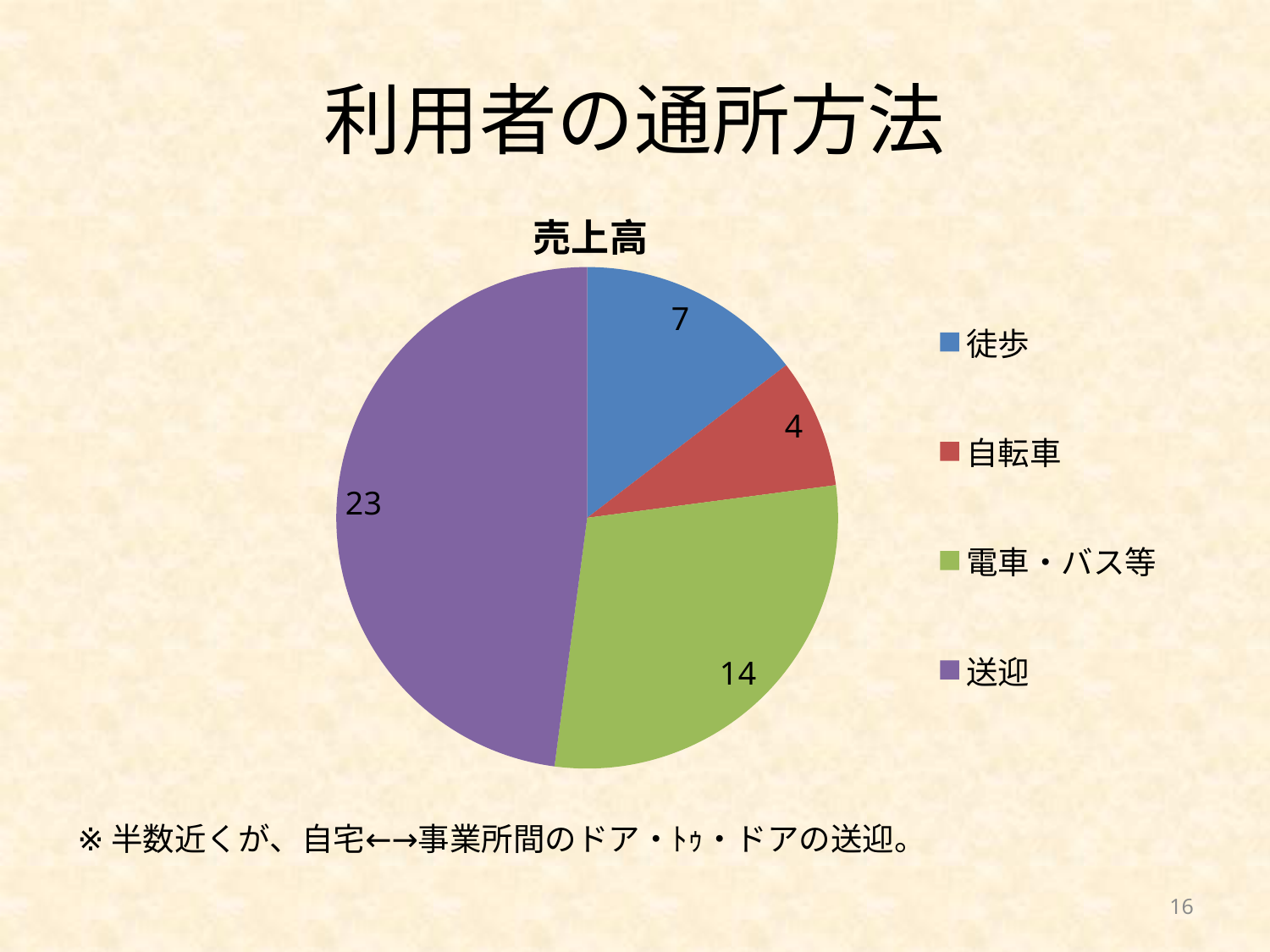
What is the title shown above the pie chart? 売上高 Which is larger, the value for 徒歩 or the value for 自転車? 徒歩 Which category has the largest slice in the pie chart? 送迎 What is the value for 電車・バス等 in the pie chart? 14 What kind of chart is shown on the slide? Pie chart What is the value for 送迎 in the pie chart? 23 What is the difference between the values for 送迎 and 電車・バス等? 9 What is the value for 徒歩 in the pie chart? 7 What is the value for 自転車 in the pie chart? 4 How many categories does the pie chart show? 4 What is the total of all slices in the pie chart? 48 Which category has the smallest slice in the pie chart? 自転車